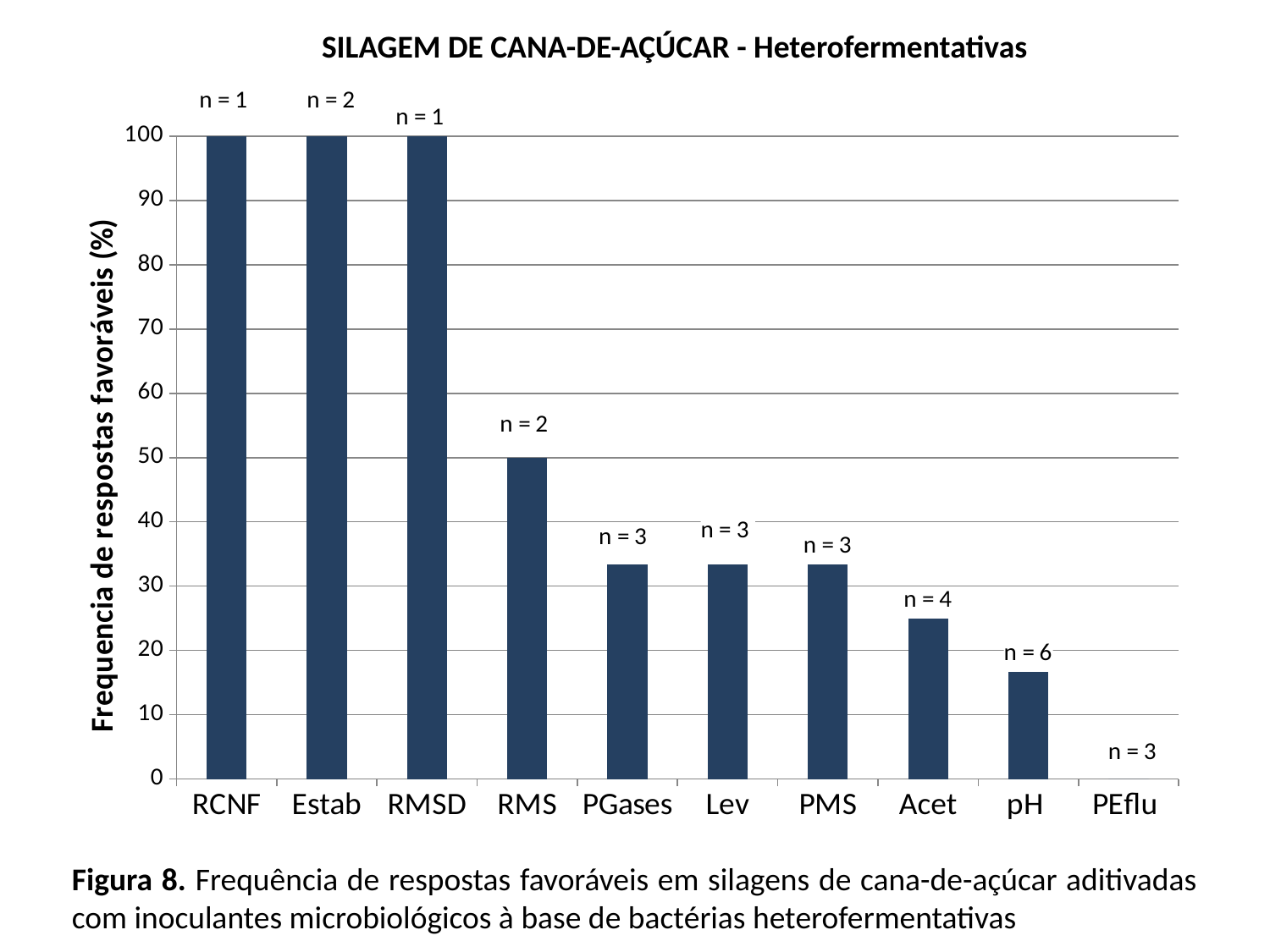
What is the frequency of favourable responses (%) for PEflu? 0 Is the value for pH greater or less than 20? less What type of chart is shown on the slide? Bar chart What is the n value printed above the pH bar? n = 6 Which has a higher frequency of favourable responses, RMS or Acet? RMS How many categories are shown on the x axis of the chart? 10 Which category has the lowest frequency of favourable responses? PEflu What is the difference in frequency of favourable responses (%) between RCNF and RMS? 50 Which categories share the highest frequency of favourable responses? RCNF, Estab and RMSD Do the values generally rise or fall from left to right along the x axis? Fall What is the frequency of favourable responses (%) for Estab? 100 What is the frequency of favourable responses (%) for RMS? 50